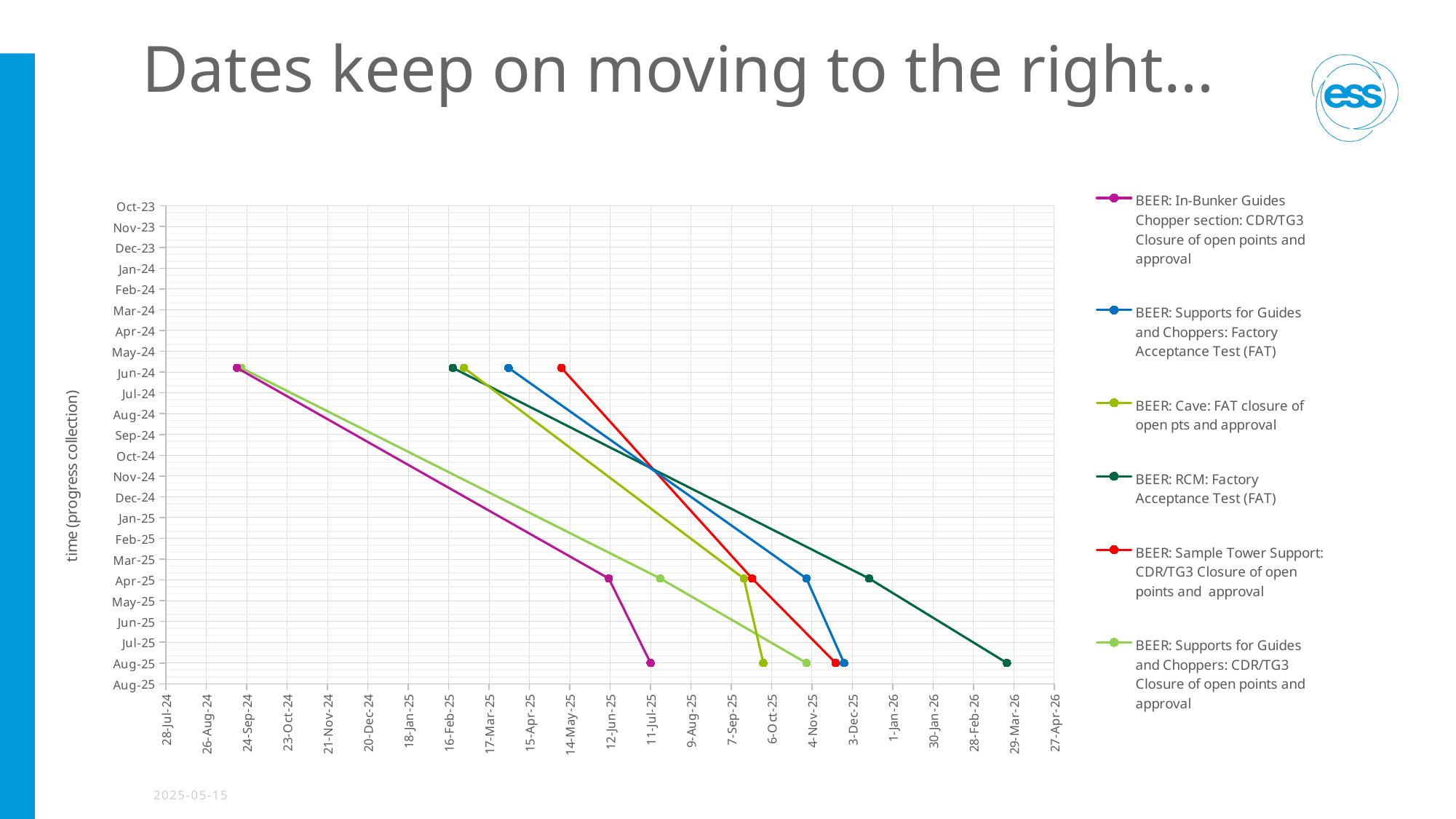
What is the label of the vertical axis? time (progress collection) Is the Jun-24 date for 'BEER: In-Bunker Guides Chopper section: CDR/TG3 Closure of open points and approval' greater (later) or less (earlier) than 23-Oct-24? less At the Aug-25 progress collection, which series has the later date: 'BEER: Supports for Guides and Choppers: Factory Acceptance Test (FAT)' or 'BEER: Cave: FAT closure of open pts and approval'? BEER: Supports for Guides and Choppers: Factory Acceptance Test (FAT) Which series has the latest (rightmost) date at the Aug-25 progress collection? BEER: RCM: Factory Acceptance Test (FAT) As the progress collection advances from Jun-24 to Aug-25, do the plotted dates move to the right (later) or to the left (earlier)? to the right (later) Is the Aug-25 date for 'BEER: RCM: Factory Acceptance Test (FAT)' greater (later) or less (earlier) than 1-Jan-26? greater What is the title of the slide containing the chart? Dates keep on moving to the right... At which three progress-collection times (y-axis ticks) are the points of each series plotted? Jun-24, Apr-25, Aug-25 What kind of chart is shown on the slide? line chart How many series does the legend list? 6 How many data points does the series 'BEER: RCM: Factory Acceptance Test (FAT)' have? 3 Which series has the earliest (leftmost) date at the Aug-25 progress collection? BEER: In-Bunker Guides Chopper section: CDR/TG3 Closure of open points and approval